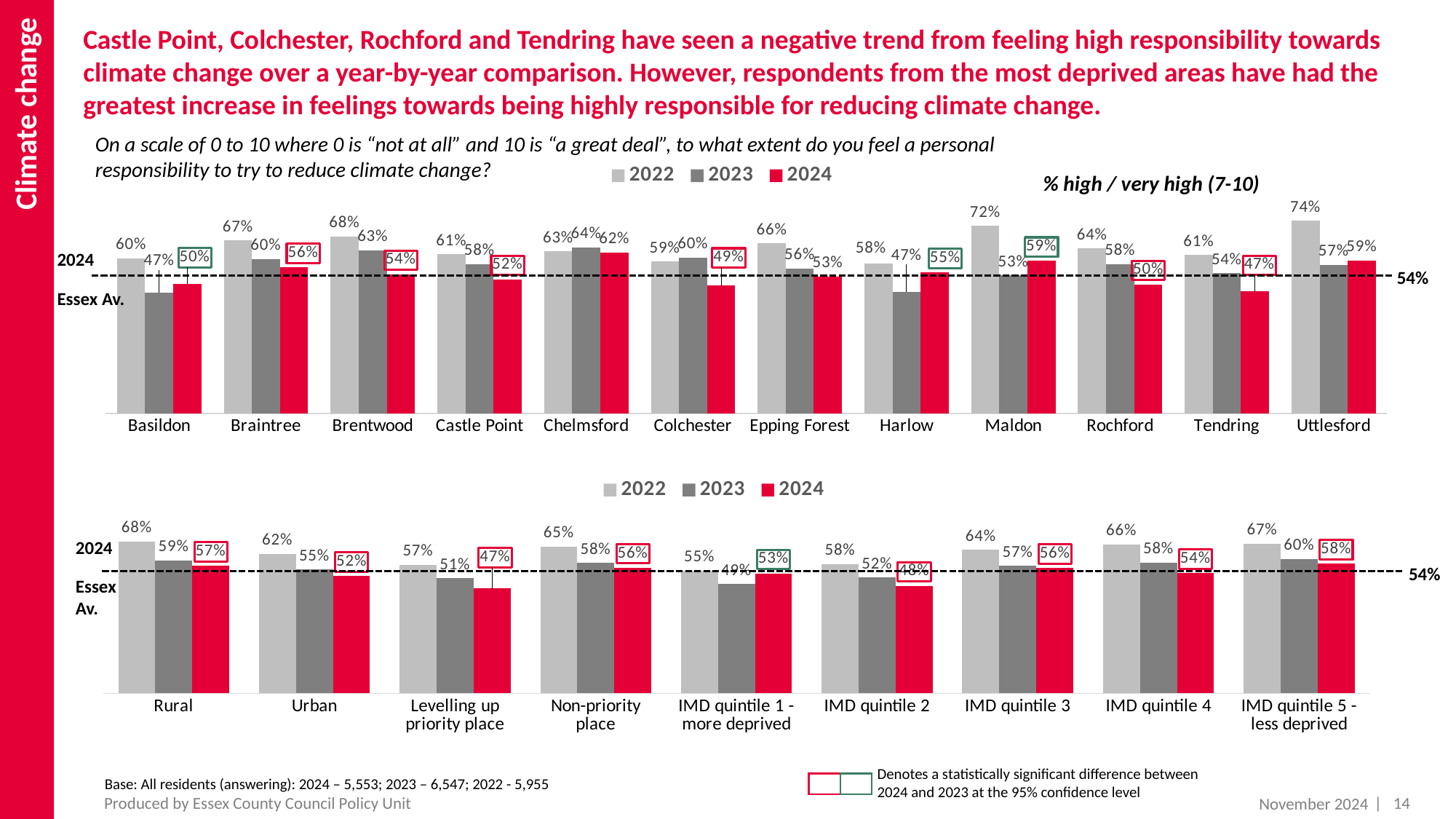
In the top chart (by district), what is the 2024 value for Maldon? 59% What kind of chart is the bottom chart (by area type)? bar chart In the top chart (by district), what is the difference between the 2022 and 2024 values for Rochford? 14% What value does the dashed Essex average line mark in both charts? 54% In the bottom chart (by area type), how many series does the legend list? 3 In the bottom chart (by area type), which category has the lowest 2024 value? Levelling up priority place In the top chart (by district), which district has the lowest 2024 value? Tendring In the bottom chart (by area type), is the 2024 value for Rural larger or smaller than the 2024 value for Urban? larger In the top chart (by district), how many districts are shown on the x axis? 12 In the bottom chart (by area type), what is the 2023 value for IMD quintile 1 - more deprived? 49% In the top chart (by district), what is the 2022 value for Uttlesford? 74% In the top chart (by district), which district has the highest 2022 value? Uttlesford